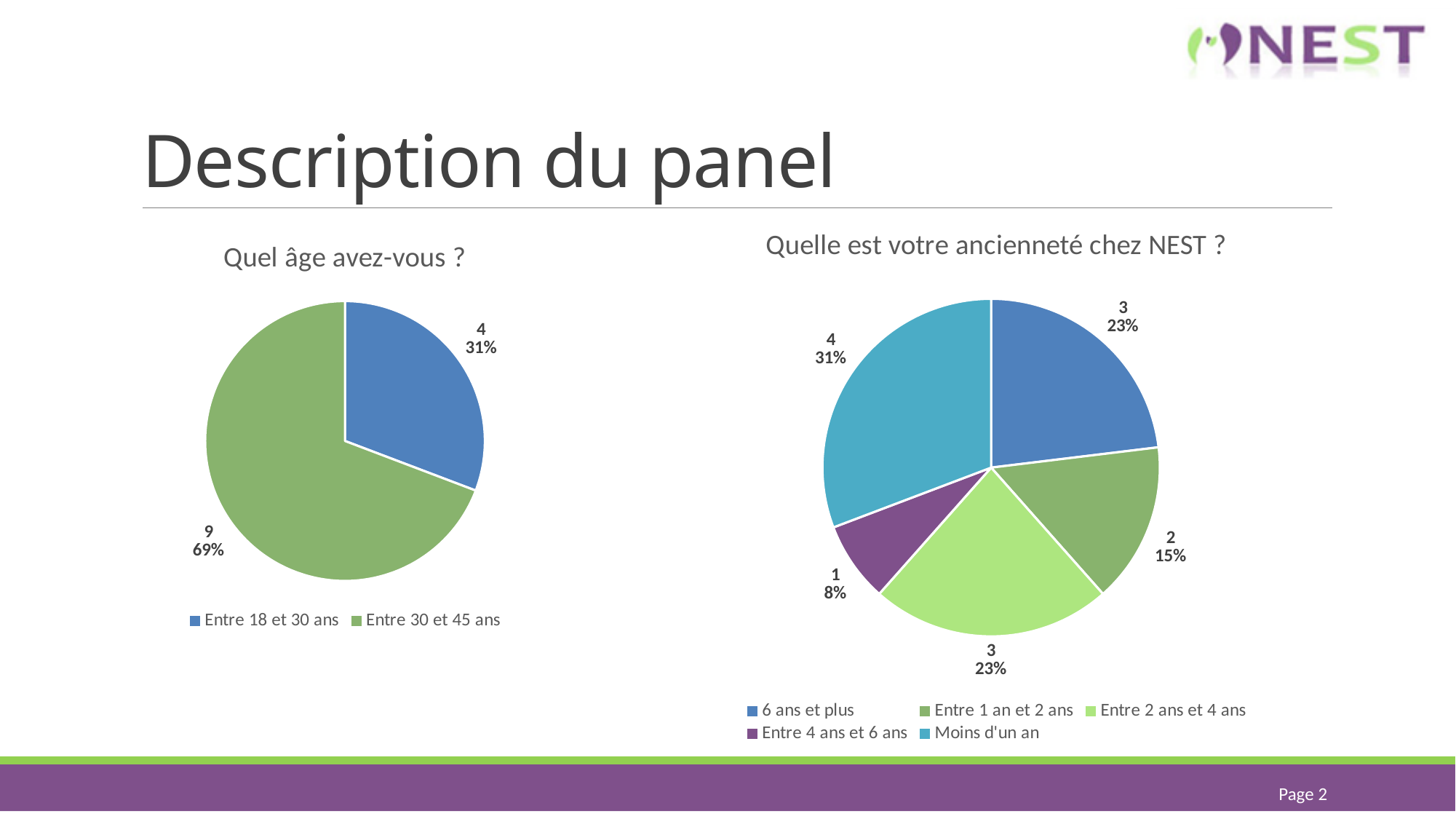
In the "Quelle est votre ancienneté chez NEST ?" chart, which is larger: "6 ans et plus" or "Entre 1 an et 2 ans"? 6 ans et plus What kind of chart is the "Quel âge avez-vous ?" chart? Pie chart In the "Quelle est votre ancienneté chez NEST ?" chart, what colour is the "Entre 4 ans et 6 ans" slice? Purple In the "Quel âge avez-vous ?" chart, how many respondents are in the "Entre 30 et 45 ans" category? 9 In the "Quelle est votre ancienneté chez NEST ?" chart, which category is the largest? Moins d'un an In the "Quelle est votre ancienneté chez NEST ?" chart, which category is the smallest? Entre 4 ans et 6 ans In the "Quel âge avez-vous ?" chart, what is the difference in count between "Entre 30 et 45 ans" and "Entre 18 et 30 ans"? 5 How many categories does the "Quelle est votre ancienneté chez NEST ?" chart have? 5 In the "Quelle est votre ancienneté chez NEST ?" chart, how many respondents are in "Moins d'un an"? 4 In the "Quel âge avez-vous ?" chart, which category is the largest? Entre 30 et 45 ans In the "Quel âge avez-vous ?" chart, what share of the pie is "Entre 18 et 30 ans"? 31% In the "Quelle est votre ancienneté chez NEST ?" chart, what share of the pie is "Entre 1 an et 2 ans"? 15%